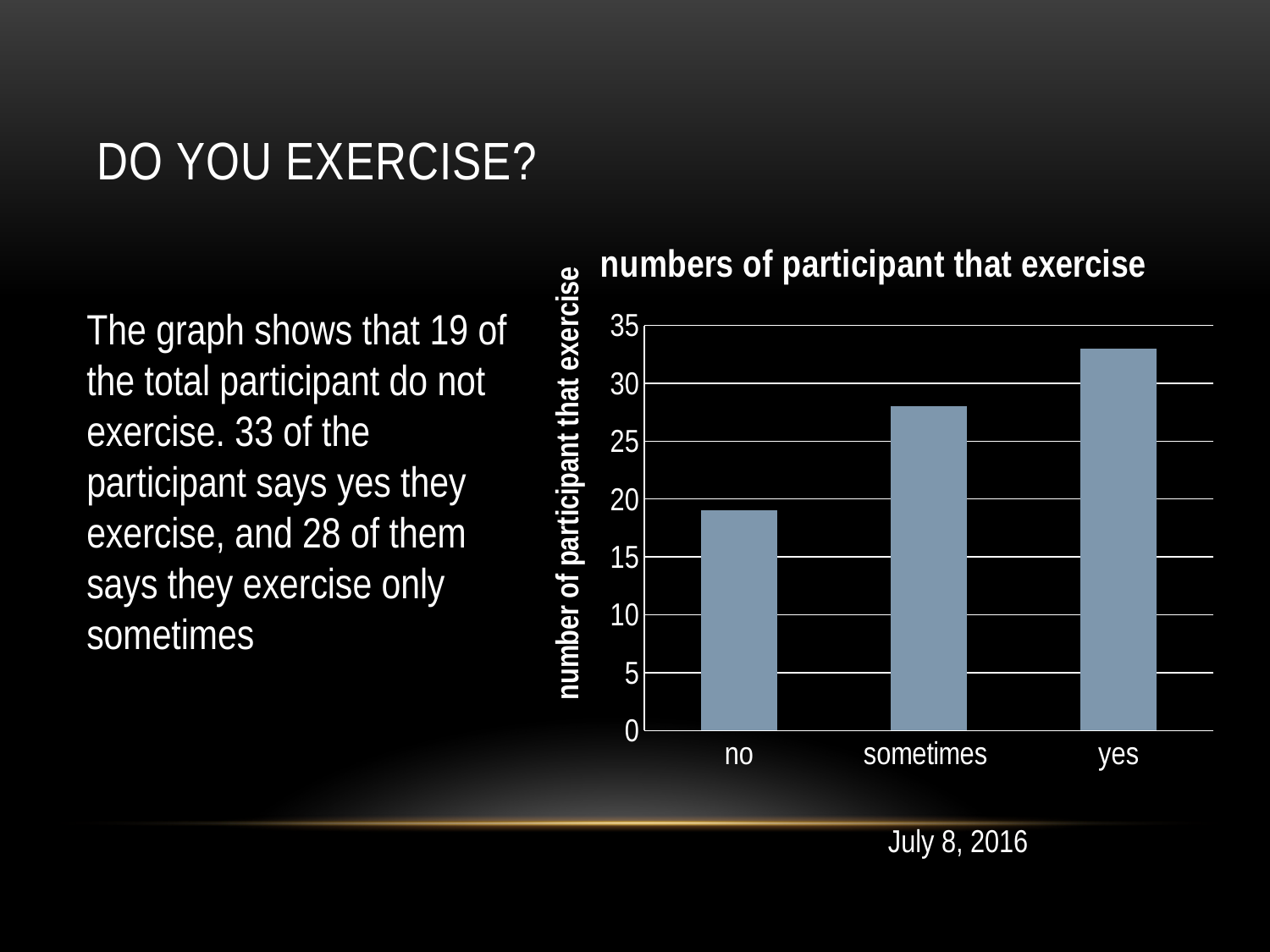
Which category has the highest bar in the chart? yes Which category has the lowest bar in the chart? no According to the slide, how many participants answered "no"? 19 What type of chart is shown on the slide? bar chart Which is larger, the bar for "yes" or the bar for "sometimes"? yes What is the title of the chart? numbers of participant that exercise Is the value for "no" greater or less than 20? less According to the slide, how many participants answered "yes"? 33 How many categories are shown on the x axis of the chart? 3 Do the bar values rise or fall from left to right across the x axis? rise According to the slide, how many participants answered "sometimes"? 28 Is the value for "sometimes" greater or less than 25? greater